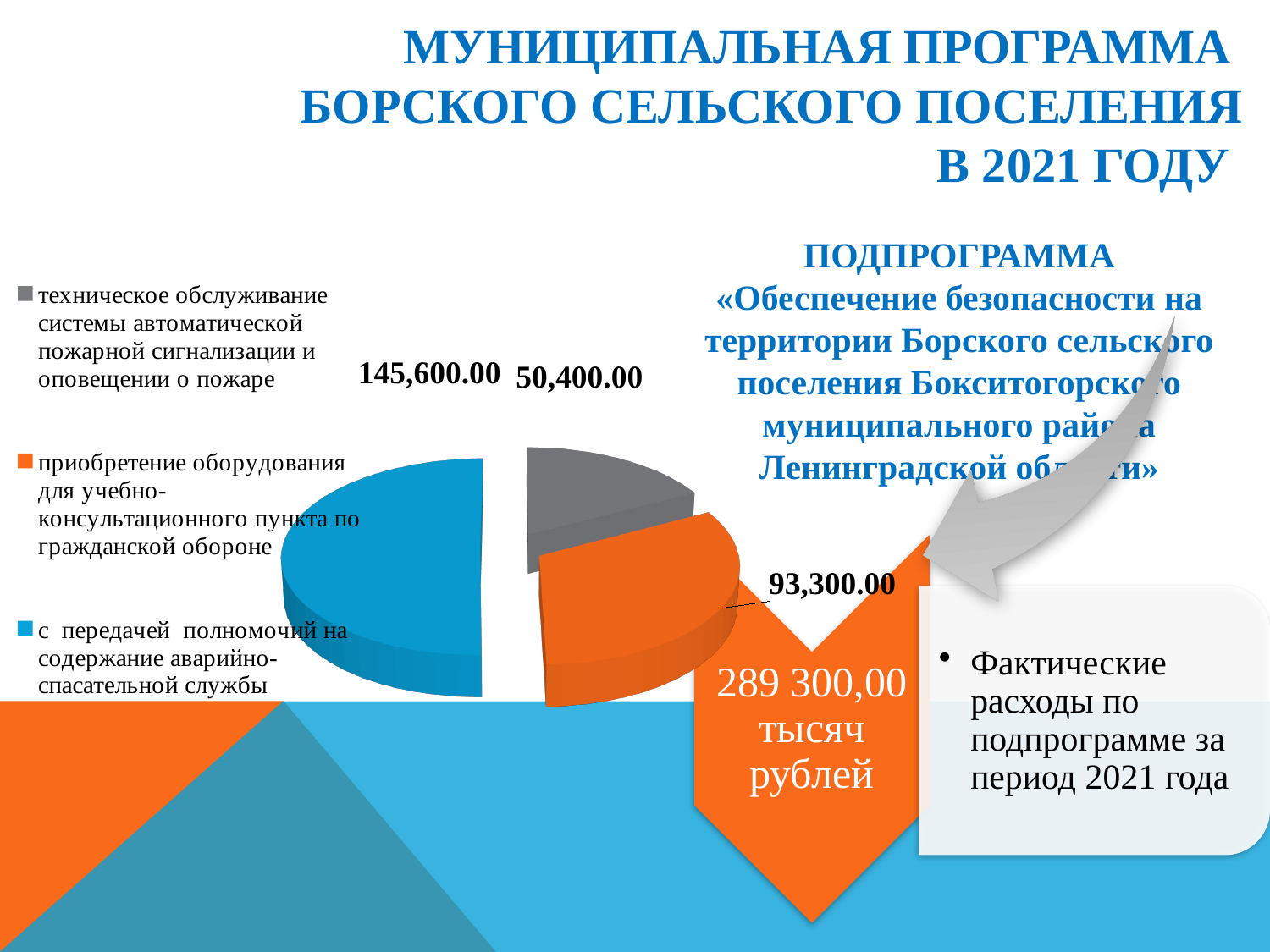
What colour is the slice for "с передачей полномочий на содержание аварийно-спасательной службы"? blue Which is larger: the value for "приобретение оборудования для учебно-консультационного пункта по гражданской обороне" or the value for "техническое обслуживание системы автоматической пожарной сигнализации и оповещении о пожаре"? приобретение оборудования для учебно-консультационного пункта по гражданской обороне What is the difference between the values 145,600.00 and 93,300.00 shown on the pie chart? 52,300.00 What is the value shown for the slice "приобретение оборудования для учебно-консультационного пункта по гражданской обороне"? 93,300.00 How many slices does the pie chart have? 3 Which category has the largest slice in the pie chart? с передачей полномочий на содержание аварийно-спасательной службы What is the value shown for the slice "с передачей полномочий на содержание аварийно-спасательной службы"? 145,600.00 How many entries does the legend of the pie chart list? 3 What is the value shown for the slice "техническое обслуживание системы автоматической пожарной сигнализации и оповещении о пожаре"? 50,400.00 What is the total of the three values shown on the pie chart? 289,300.00 What kind of chart is shown on the slide? pie chart Which category has the smallest slice in the pie chart? техническое обслуживание системы автоматической пожарной сигнализации и оповещении о пожаре